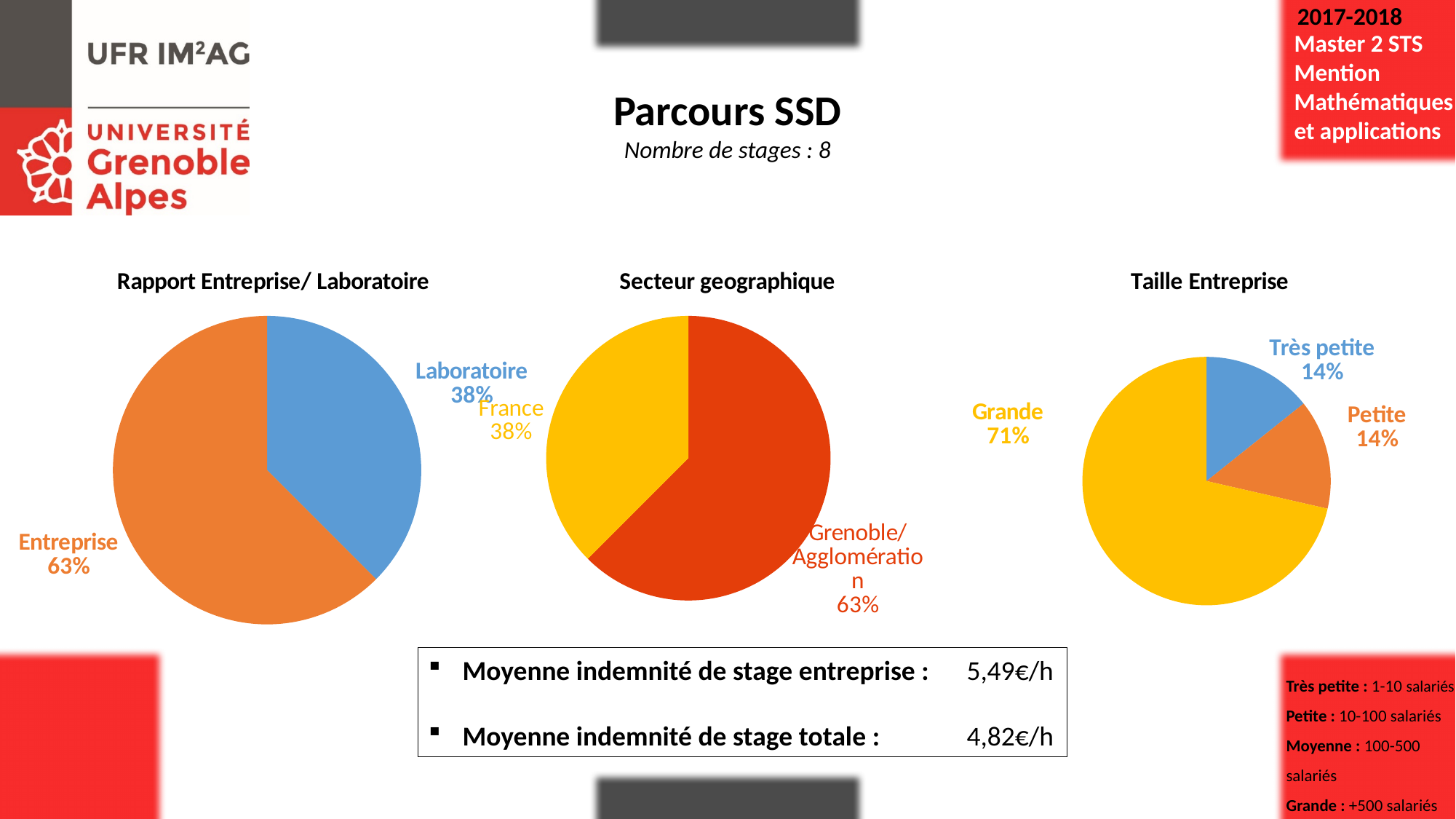
In the 'Taille Entreprise' chart, what share is labelled for Très petite? 14% In the 'Secteur geographique' chart, which slice is the smallest? France What kind of chart is the 'Secteur geographique' chart? Pie chart In the 'Rapport Entreprise/ Laboratoire' chart, what share is labelled for Entreprise? 63% In the 'Rapport Entreprise/ Laboratoire' chart, which slice is the largest? Entreprise In the 'Taille Entreprise' chart, what share is labelled for Grande? 71% In the 'Rapport Entreprise/ Laboratoire' chart, what colour is the Laboratoire slice? Blue In the 'Taille Entreprise' chart, what is the difference in percentage points between Grande and Petite? 57% In the 'Taille Entreprise' chart, how many slices does the pie have? 3